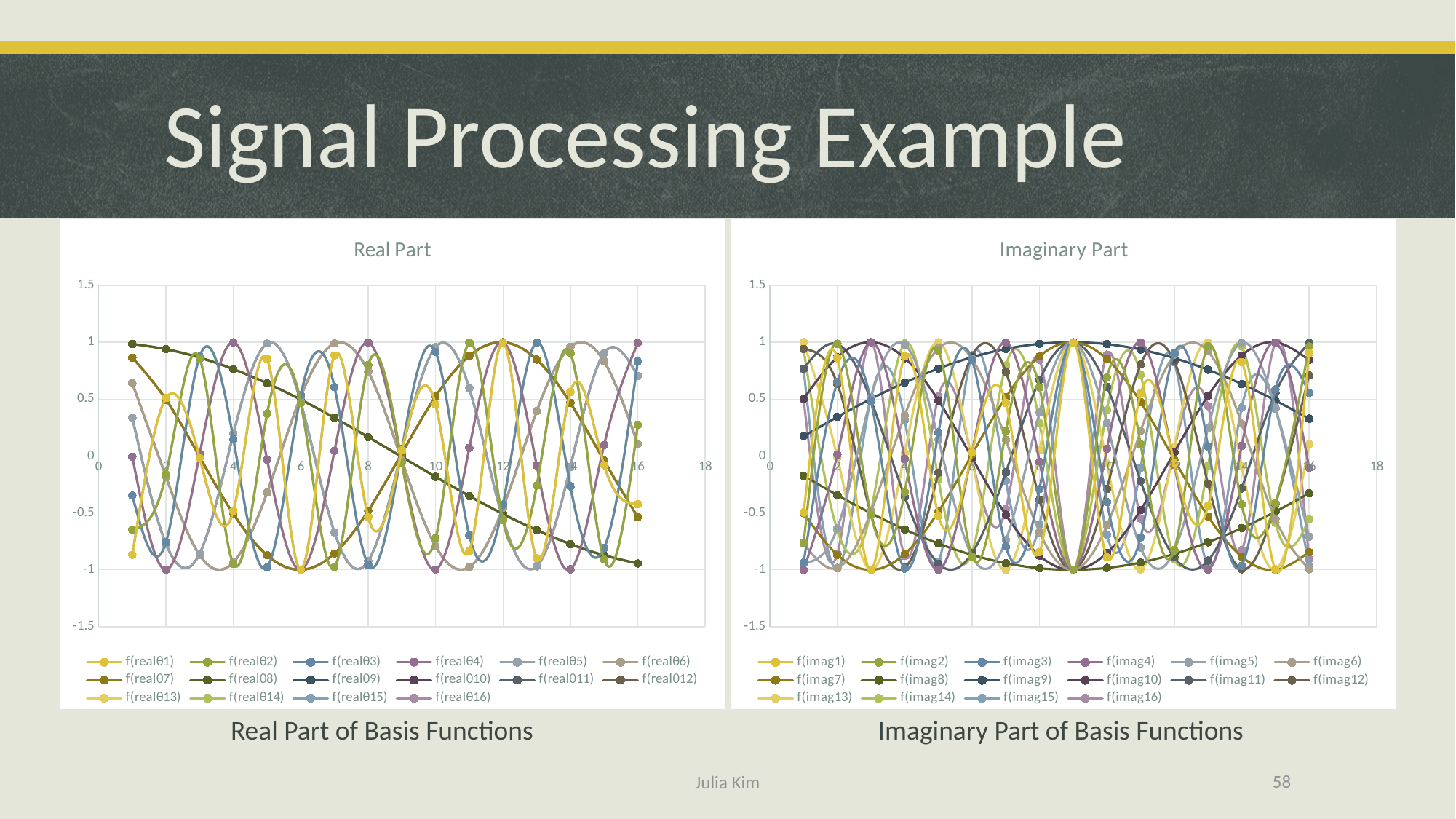
What is the title of the chart on the left side of the slide? Real Part In the Imaginary Part chart, what is the lowest value reached by any of the plotted series? -1 In the Imaginary Part chart, what is the highest value reached by any of the plotted series? 1 How many series does the legend of the Real Part chart list? 16 What is the title of the chart on the right side of the slide? Imaginary Part What kind of chart is the Imaginary Part chart? line chart In the Imaginary Part chart, is the value of f(imag8) at x = 8 greater or less than -0.5? less In the Real Part chart, what is the lowest value reached by any of the plotted series? -1 How many series does the legend of the Imaginary Part chart list? 16 In the Real Part chart, what is the highest value reached by any of the plotted series? 1 What kind of chart is the Real Part chart? line chart